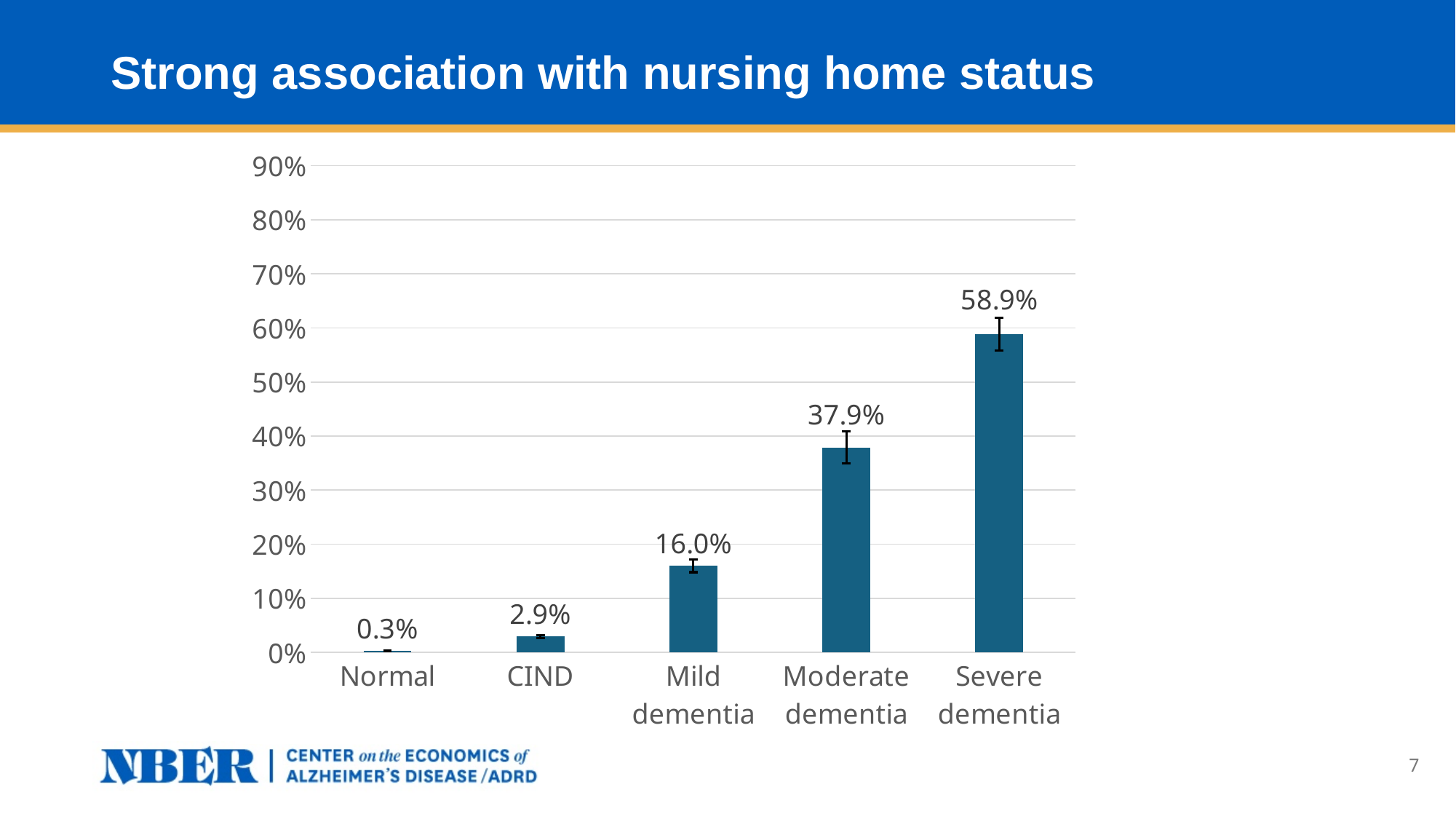
Which is larger, the value for Mild dementia or the value for CIND? Mild dementia Do the values rise or fall from Normal to Severe dementia along the x axis? Rise How many categories are shown on the x axis? 5 What is the difference between the values for Severe dementia and Moderate dementia? 21.0% What is the value for Normal? 0.3% What kind of chart is shown on the slide? Bar chart What is the value for CIND? 2.9% What is the value for Mild dementia? 16.0% Which category has the highest value? Severe dementia What is the value for Severe dementia? 58.9% What is the value for Moderate dementia? 37.9% Which category has the lowest value? Normal